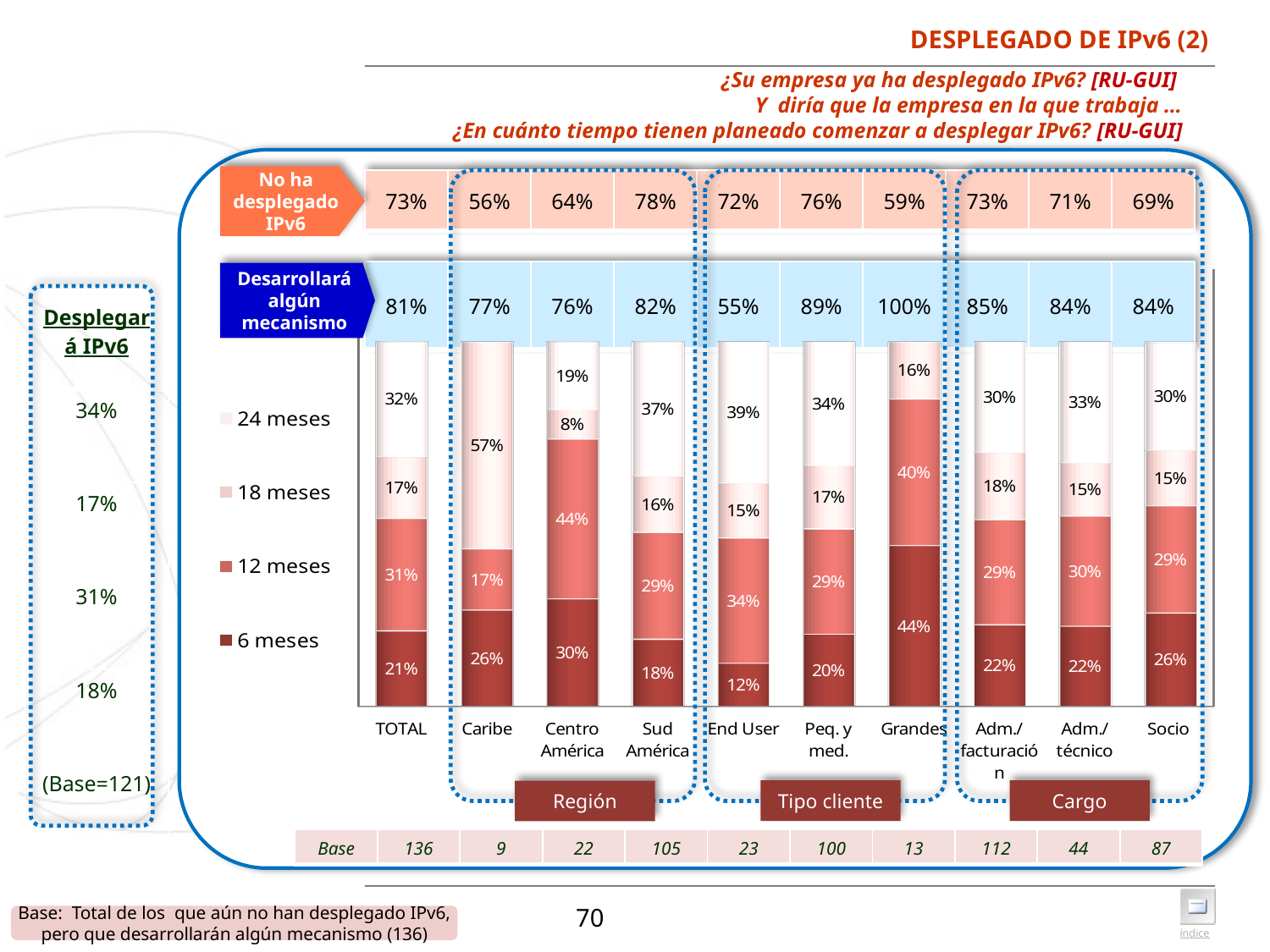
Which is larger, the 24 meses value for Adm./técnico or for Socio? Adm./técnico What is the value of the 18 meses segment for Sud América? 16% What is the difference between the 12 meses values for End User and Peq. y med.? 5% What type of chart is shown on the slide? stacked bar chart Which legend entry is shown in the darkest red colour? 6 meses Which category has the lowest 6 meses value? End User What is the value of the 12 meses segment for Centro América? 44% Which category has the highest 6 meses value? Grandes How many categories are shown along the x axis of the chart? 10 How many series does the chart legend list? 4 What is the value of the 6 meses segment for TOTAL? 21%